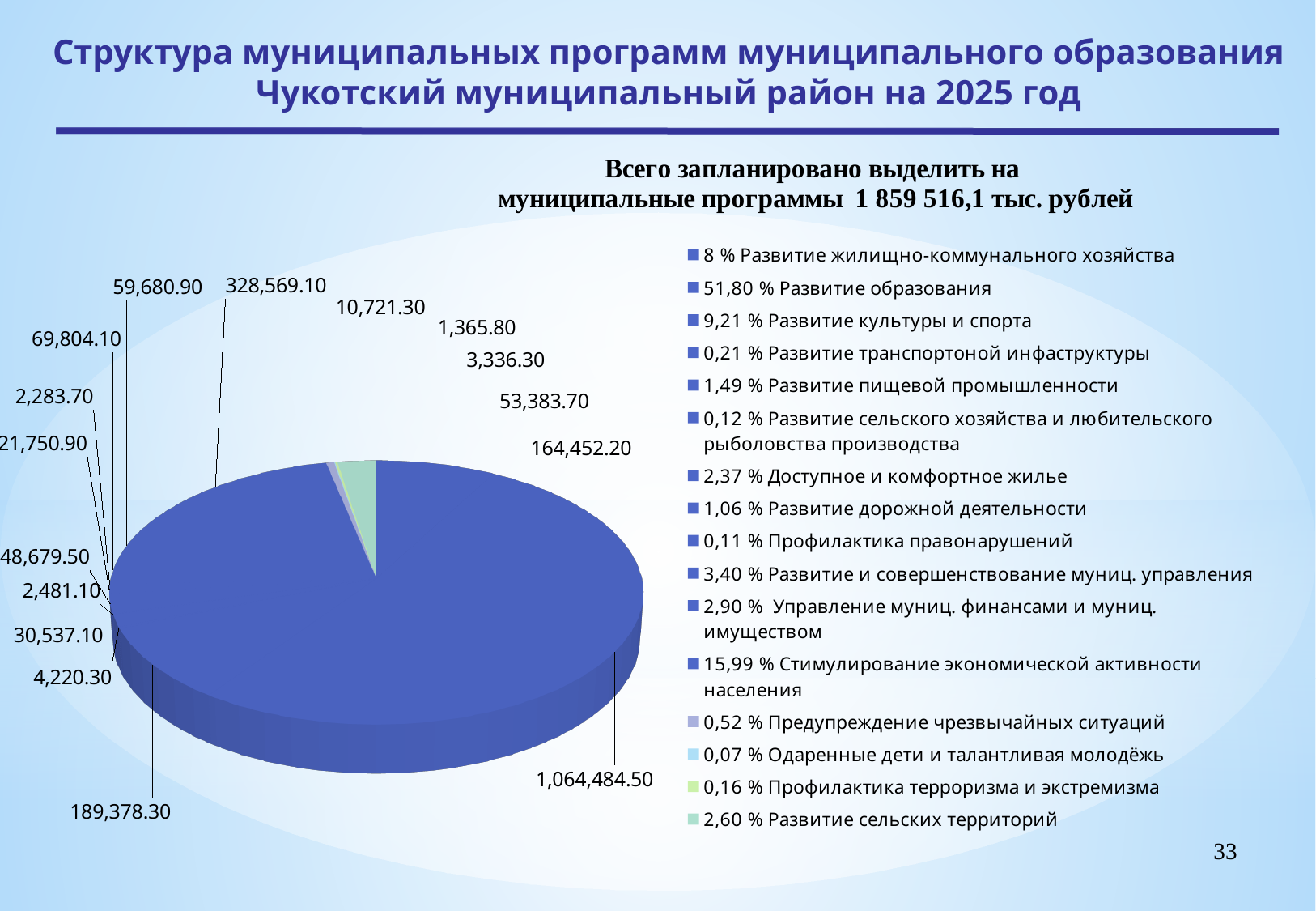
What kind of chart is shown on the slide? pie chart Which labelled value is larger: 53,383.70 or 48,679.50? 53,383.70 What year does the slide title refer to? 2025 According to the legend, what percentage share does 'Стимулирование экономической активности населения' have? 15,99 % Which legend entry has the smallest percentage share? Одаренные дети и талантливая молодёжь (0,07 %) What total amount is planned for municipal programmes according to the text above the chart? 1 859 516,1 тыс. рублей According to the legend, what percentage share does 'Развитие образования' have? 51,80 % How many data labels (slices) are shown on the pie chart? 16 How many entries does the chart legend list? 16 What is the largest value labelled on the pie chart? 1,064,484.50 What is the difference between the labelled values 1,064,484.50 and 328,569.10? 735,915.40 What is the smallest value labelled on the pie chart? 1,365.80